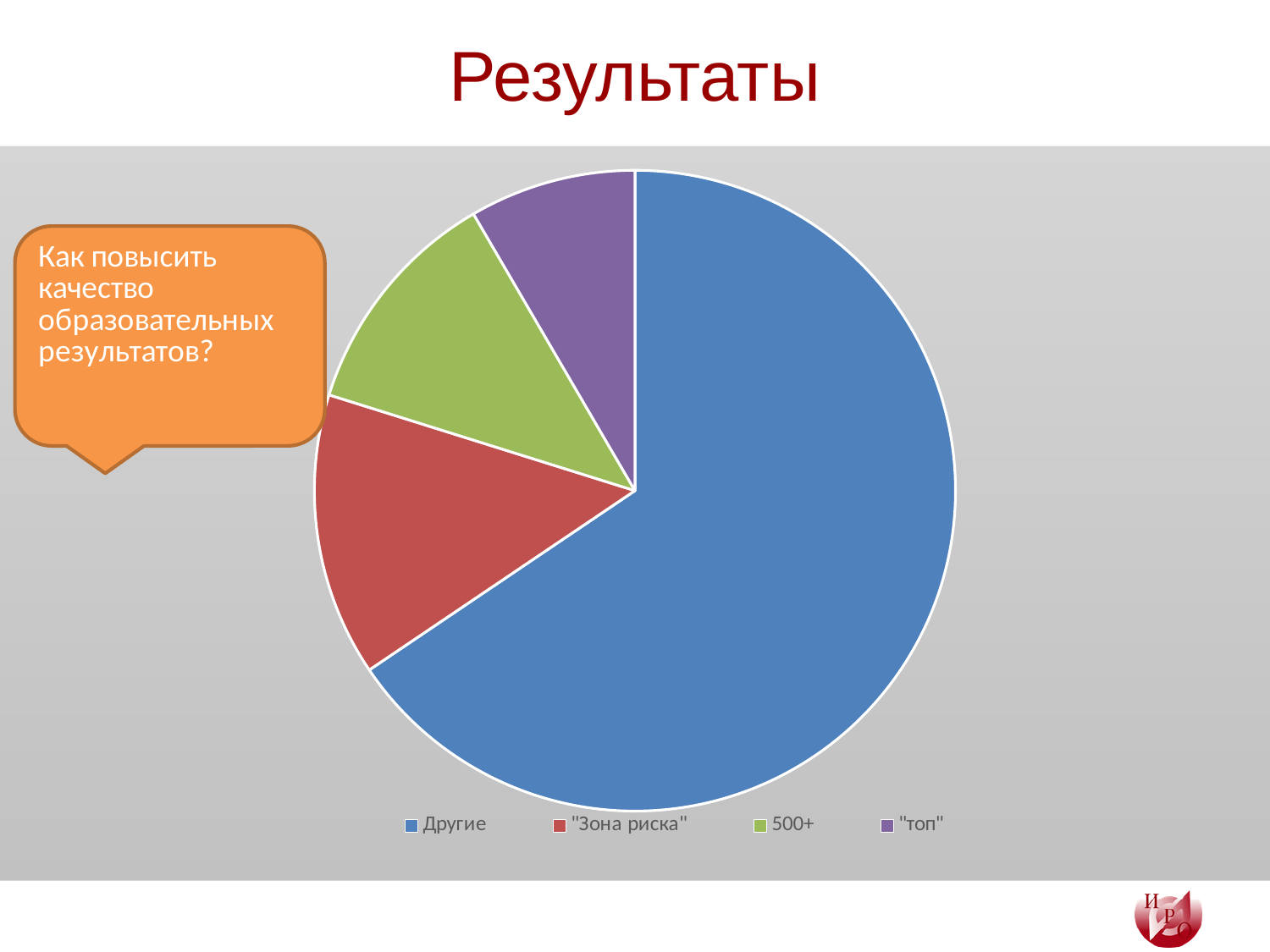
How many entries does the legend of the pie chart list? 4 Does the Другие slice take up more or less than half of the pie chart? more What kind of chart is shown on the slide? pie chart What is the title of the slide containing the pie chart? Результаты Which slice is larger in the pie chart, Другие or "Зона риска"? Другие What colour is the Другие slice in the pie chart? blue Which category has the smallest slice in the pie chart? "топ" Which category has the largest slice in the pie chart? Другие How many slices does the pie chart have? 4 Which slice is larger in the pie chart, 500+ or "топ"? 500+